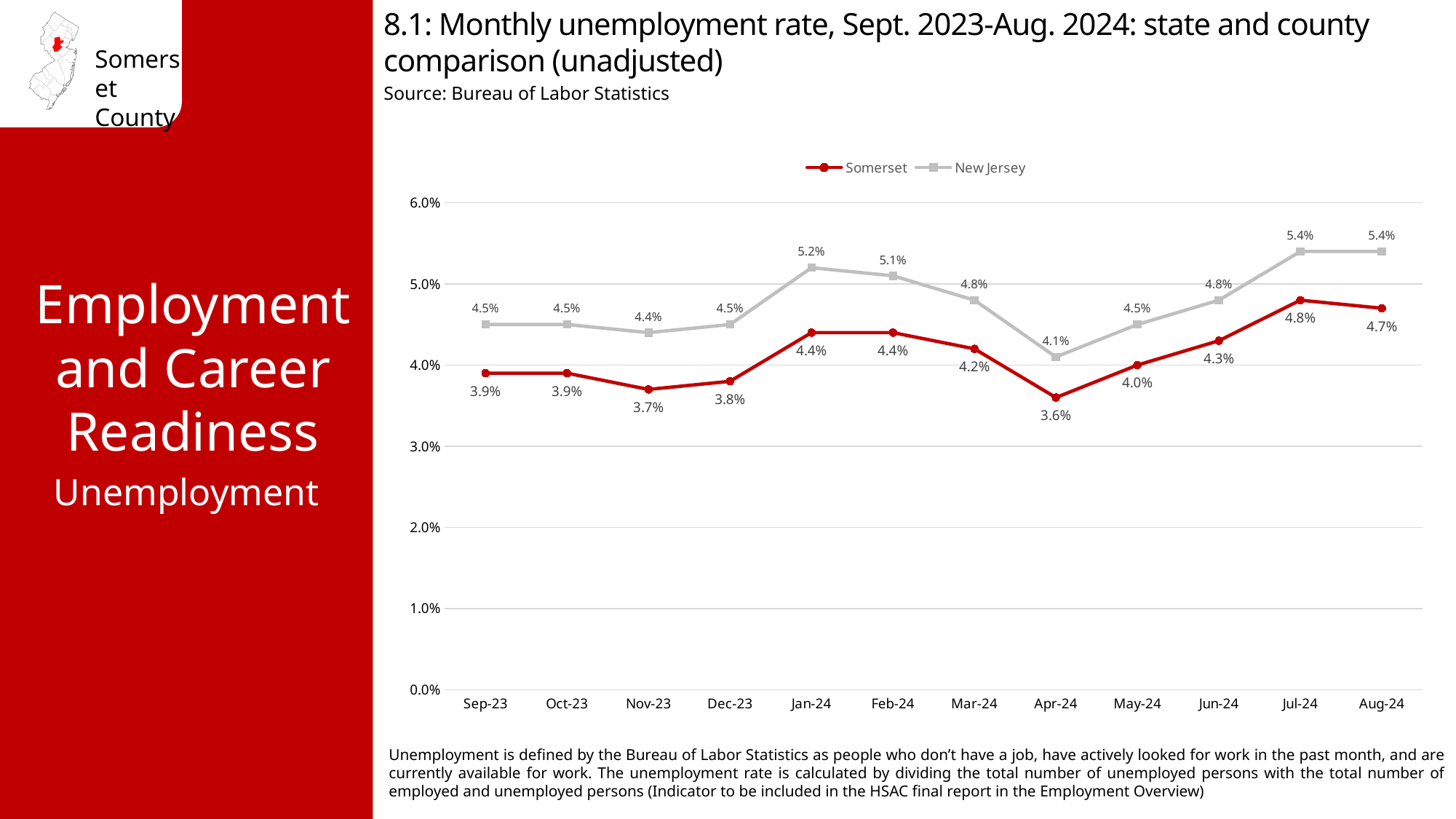
In which month did New Jersey's unemployment rate reach its lowest value? Apr-24 How many months are plotted on the x axis? 12 Which colour is used for the Somerset line? Red What is the source cited for the chart? Bureau of Labor Statistics In which month did Somerset's unemployment rate reach its highest value? Jul-24 How many series does the legend list? 2 What was the unemployment rate for New Jersey in Jan-24? 5.2% What is the difference between the New Jersey and Somerset unemployment rates in Aug-24? 0.7% What kind of chart is shown on the slide? Line chart What was the unemployment rate for Somerset in Apr-24? 3.6% Which series had the higher unemployment rate in Mar-24, Somerset or New Jersey? New Jersey Did Somerset's unemployment rate rise or fall from Apr-24 to Jul-24? Rise